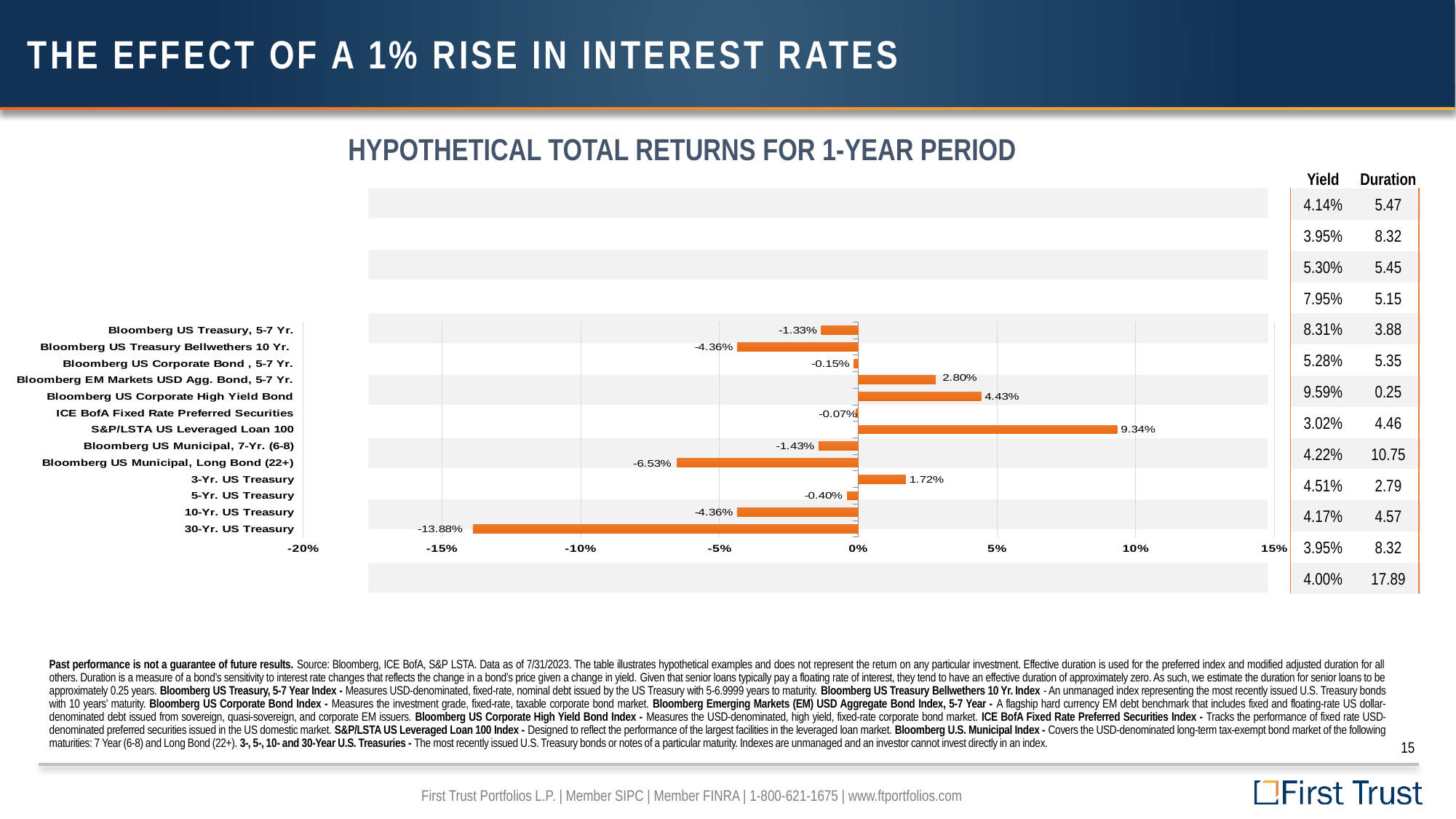
What is the value shown for Bloomberg US Municipal, Long Bond (22+)? -6.53% Which category has the lowest hypothetical total return? 30-Yr. US Treasury Is the value for Bloomberg US Treasury Bellwethers 10 Yr. greater or less than -5%? greater What is the hypothetical total return shown for the 30-Yr. US Treasury? -13.88% What is the value shown for Bloomberg US Corporate High Yield Bond? 4.43% What is the difference between the values for Bloomberg US Corporate High Yield Bond and Bloomberg EM Markets USD Agg. Bond, 5-7 Yr.? 1.63% How many categories are plotted in the chart? 13 What kind of chart is shown on the slide? Bar chart Which has a higher value, 3-Yr. US Treasury or 5-Yr. US Treasury? 3-Yr. US Treasury Which category has the highest hypothetical total return? S&P/LSTA US Leveraged Loan 100 What is the title of the chart? Hypothetical Total Returns for 1-Year Period What is the hypothetical total return shown for the S&P/LSTA US Leveraged Loan 100? 9.34%